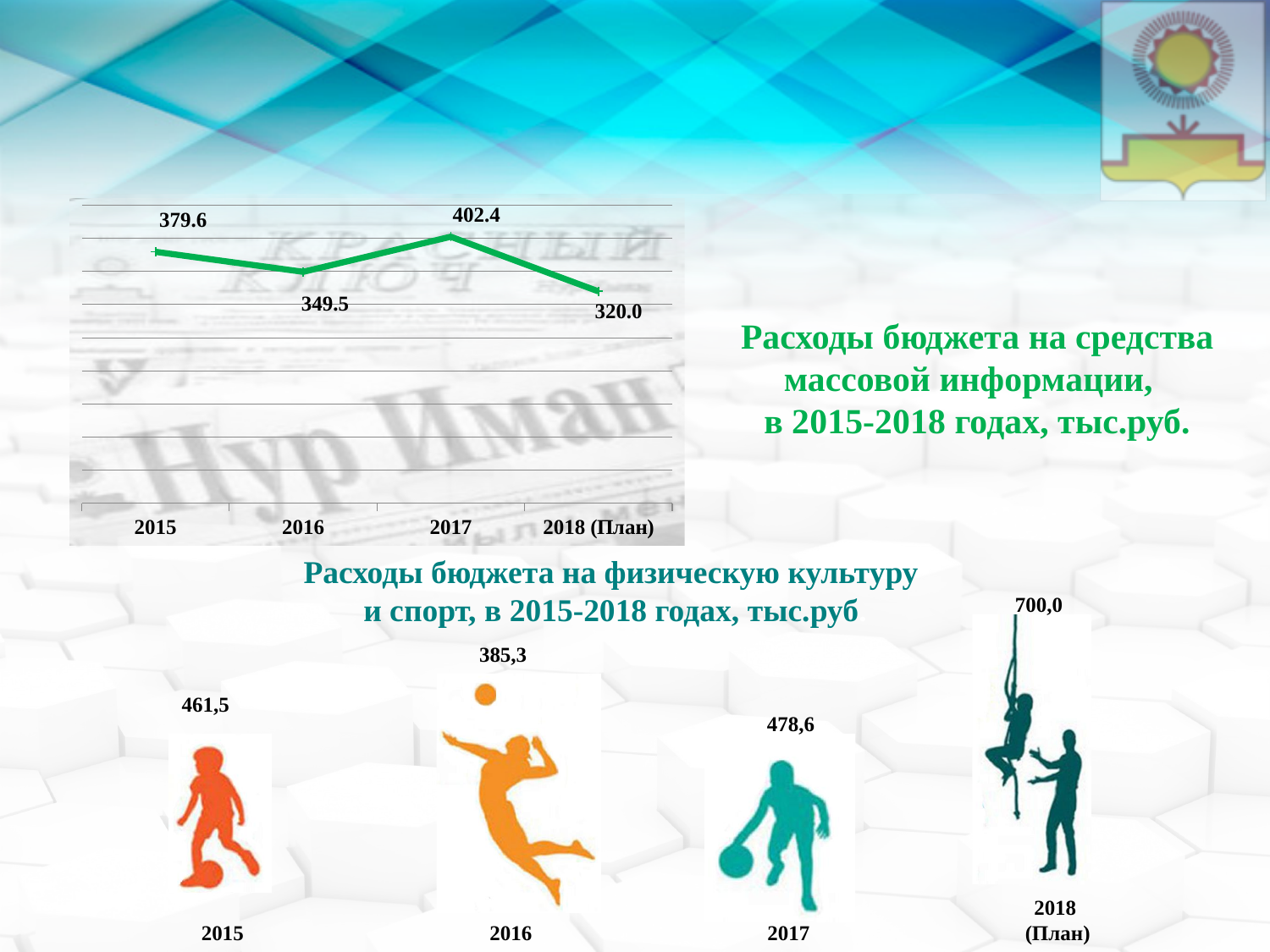
In the chart 'Расходы бюджета на средства массовой информации, в 2015-2018 годах, тыс.руб.', what is the value for 2018 (План)? 320.0 What kind of chart is 'Расходы бюджета на средства массовой информации, в 2015-2018 годах, тыс.руб.'? line chart In the chart 'Расходы бюджета на средства массовой информации, в 2015-2018 годах, тыс.руб.', what is the difference between the values for 2015 and 2016? 30.1 In the chart 'Расходы бюджета на физическую культуру и спорт, в 2015-2018 годах, тыс.руб', which year has the lowest value? 2016 In the chart 'Расходы бюджета на физическую культуру и спорт, в 2015-2018 годах, тыс.руб', which is larger, the value for 2015 or the value for 2017? 2017 In the chart 'Расходы бюджета на физическую культуру и спорт, в 2015-2018 годах, тыс.руб', what is the difference between the values for 2018 (План) and 2017? 221,4 How many data points are plotted in the chart 'Расходы бюджета на средства массовой информации, в 2015-2018 годах, тыс.руб.'? 4 In the chart 'Расходы бюджета на средства массовой информации, в 2015-2018 годах, тыс.руб.', which year has the lowest value? 2018 (План) In the chart 'Расходы бюджета на средства массовой информации, в 2015-2018 годах, тыс.руб.', what is the value for 2017? 402.4 In the chart 'Расходы бюджета на физическую культуру и спорт, в 2015-2018 годах, тыс.руб', what is the value for 2016? 385,3 In the chart 'Расходы бюджета на физическую культуру и спорт, в 2015-2018 годах, тыс.руб', what is the value for 2018 (План)? 700,0 In the chart 'Расходы бюджета на средства массовой информации, в 2015-2018 годах, тыс.руб.', which year has the highest value? 2017